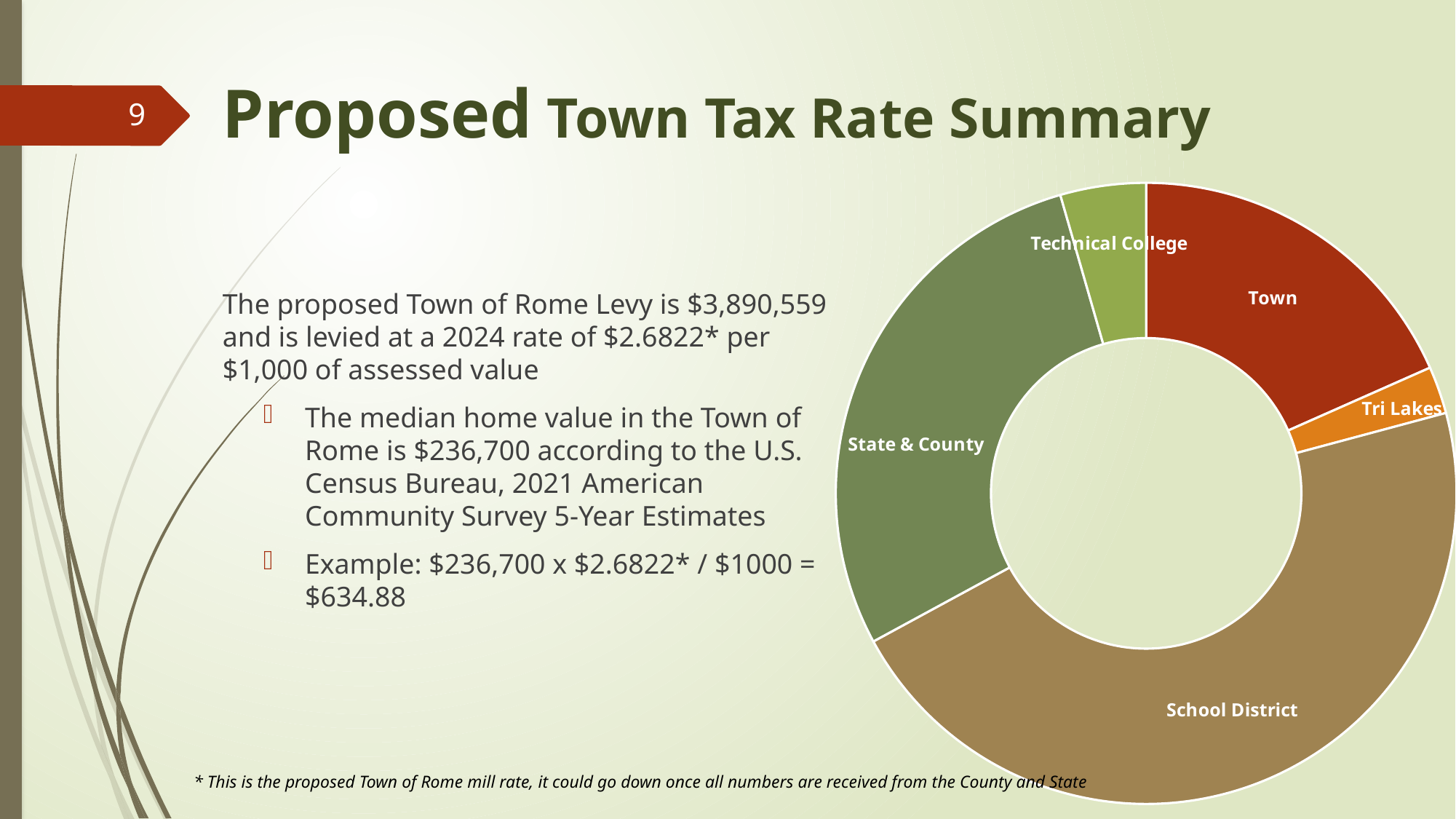
Which category has the largest slice of the chart? School District How many slices does the chart have? 5 What kind of chart is shown on the slide? doughnut chart Which slice is larger, School District or Town? School District Which slice is larger, School District or State & County? School District Which slice is larger, State & County or Technical College? State & County What colour is the School District slice of the chart? brown Which category has the smallest slice of the chart? Tri Lakes What colour is the Town slice of the chart? red